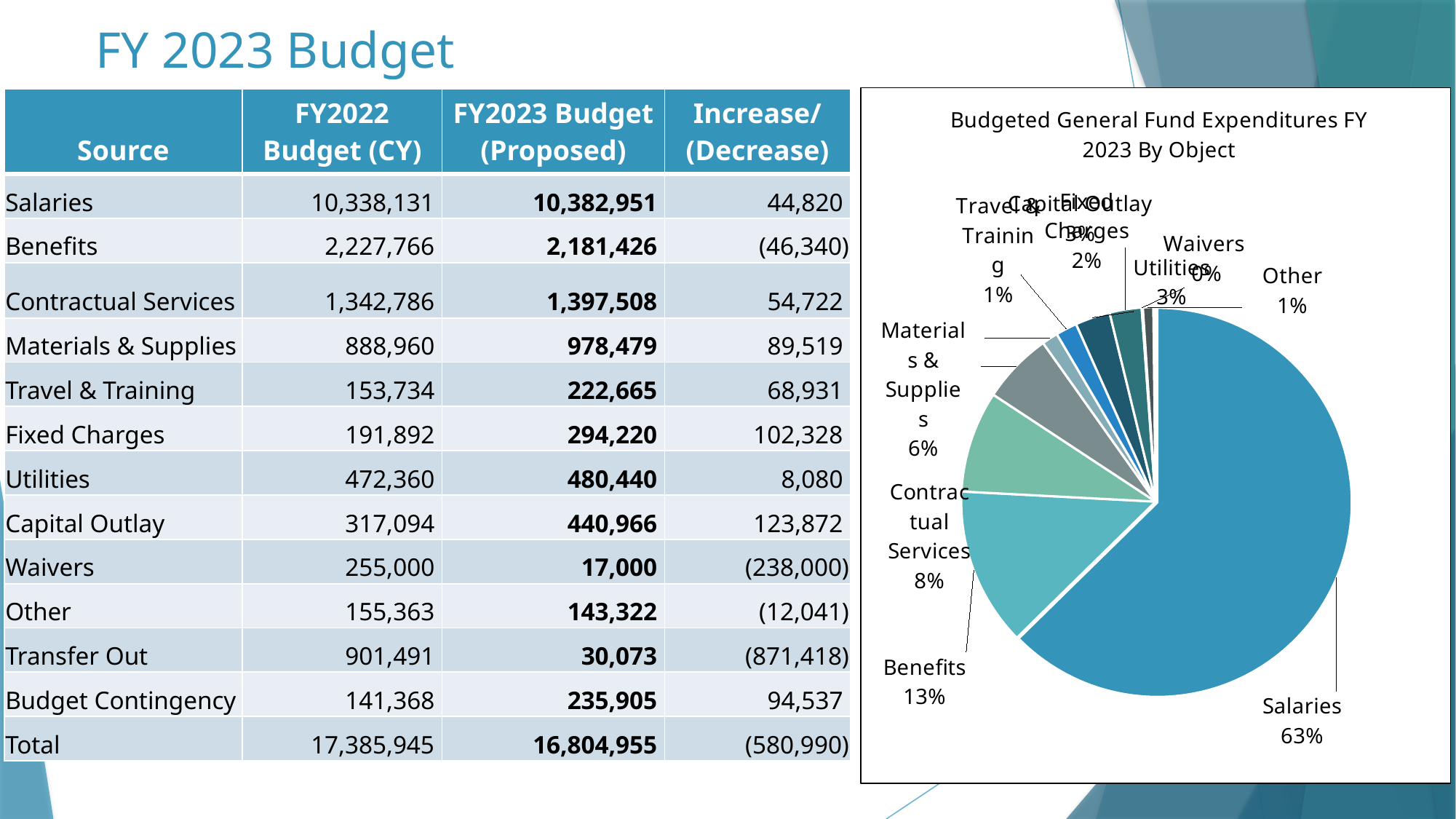
In the pie chart, is the Salaries share greater or less than 50%? greater In the pie chart, what share of expenditures is Benefits? 13% Which category has the largest slice in the pie chart? Salaries In the pie chart, what share of expenditures is Salaries? 63% In the pie chart, what share of expenditures is Utilities? 3% In the pie chart, what is the difference in percentage points between the Salaries share and the Benefits share? 50 What is the title of the pie chart? Budgeted General Fund Expenditures FY 2023 By Object In the pie chart, which slice is larger, Benefits or Contractual Services? Benefits What kind of chart is shown on the right side of the slide? pie chart